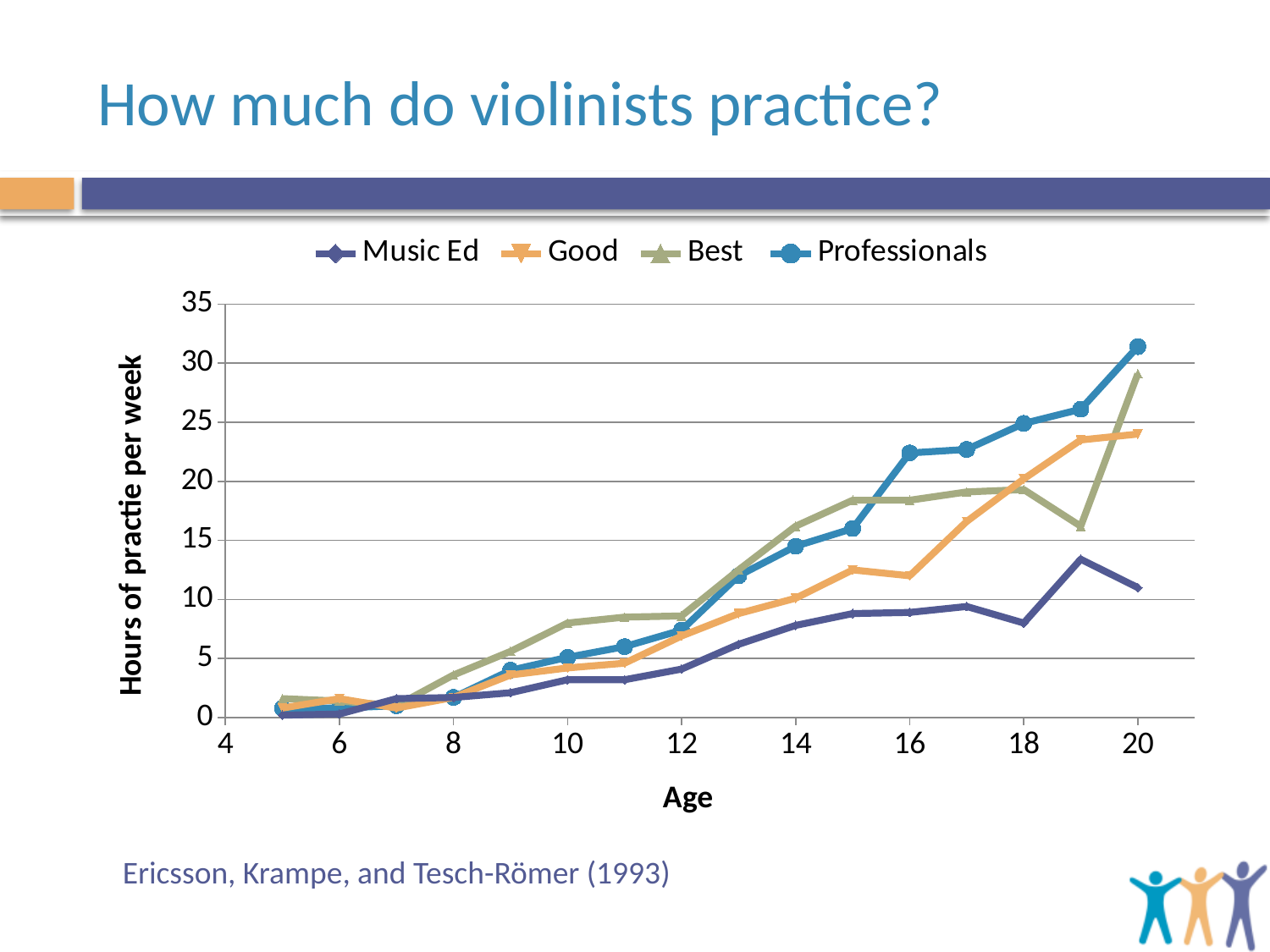
At age 12, which is larger: the value for Best or the value for Music Ed? Best Do the values for Professionals generally rise or fall as age increases? rise Which series has the lowest value at age 20? Music Ed How many series does the legend list? 4 Is the value for Professionals at age 20 greater or less than 30? greater Which series has the highest value at age 20? Professionals Is the value for Music Ed at age 20 greater or less than 15? less Is the value for Good at age 16 greater or less than 15? less What is the title of the x axis? Age What are the series names listed in the legend? Music Ed, Good, Best, Professionals What kind of chart is shown on the slide? line chart